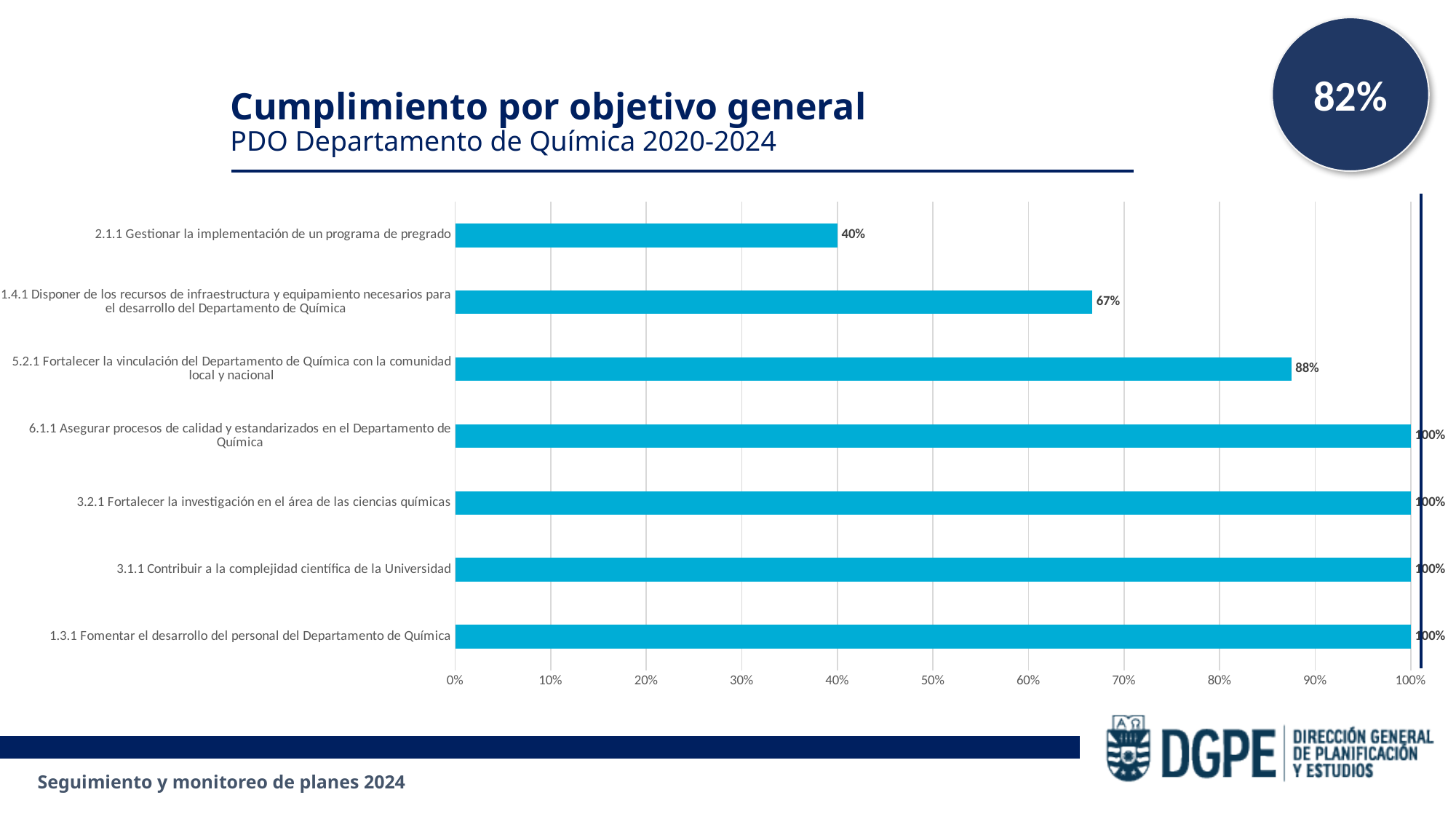
What is the value for objective 5.2.1 Fortalecer la vinculación del Departamento de Química con la comunidad local y nacional? 88% What is the value for objective 2.1.1 Gestionar la implementación de un programa de pregrado? 40% Which objective has the lowest value in the chart? 2.1.1 Gestionar la implementación de un programa de pregrado What is the difference between the values for objective 1.4.1 and objective 2.1.1? 27% What is the value for objective 1.4.1 Disponer de los recursos de infraestructura y equipamiento necesarios para el desarrollo del Departamento de Química? 67% How many objectives are shown in the chart? 7 Which is larger, the value for objective 1.4.1 or the value for objective 5.2.1? 5.2.1 Is the value for objective 1.4.1 greater or less than 60%? greater How many objectives have a value of 100%? 4 What is the value for objective 3.2.1 Fortalecer la investigación en el área de las ciencias químicas? 100% What kind of chart is shown on the slide? Bar chart What is the difference between the values for objective 5.2.1 and objective 2.1.1? 48%